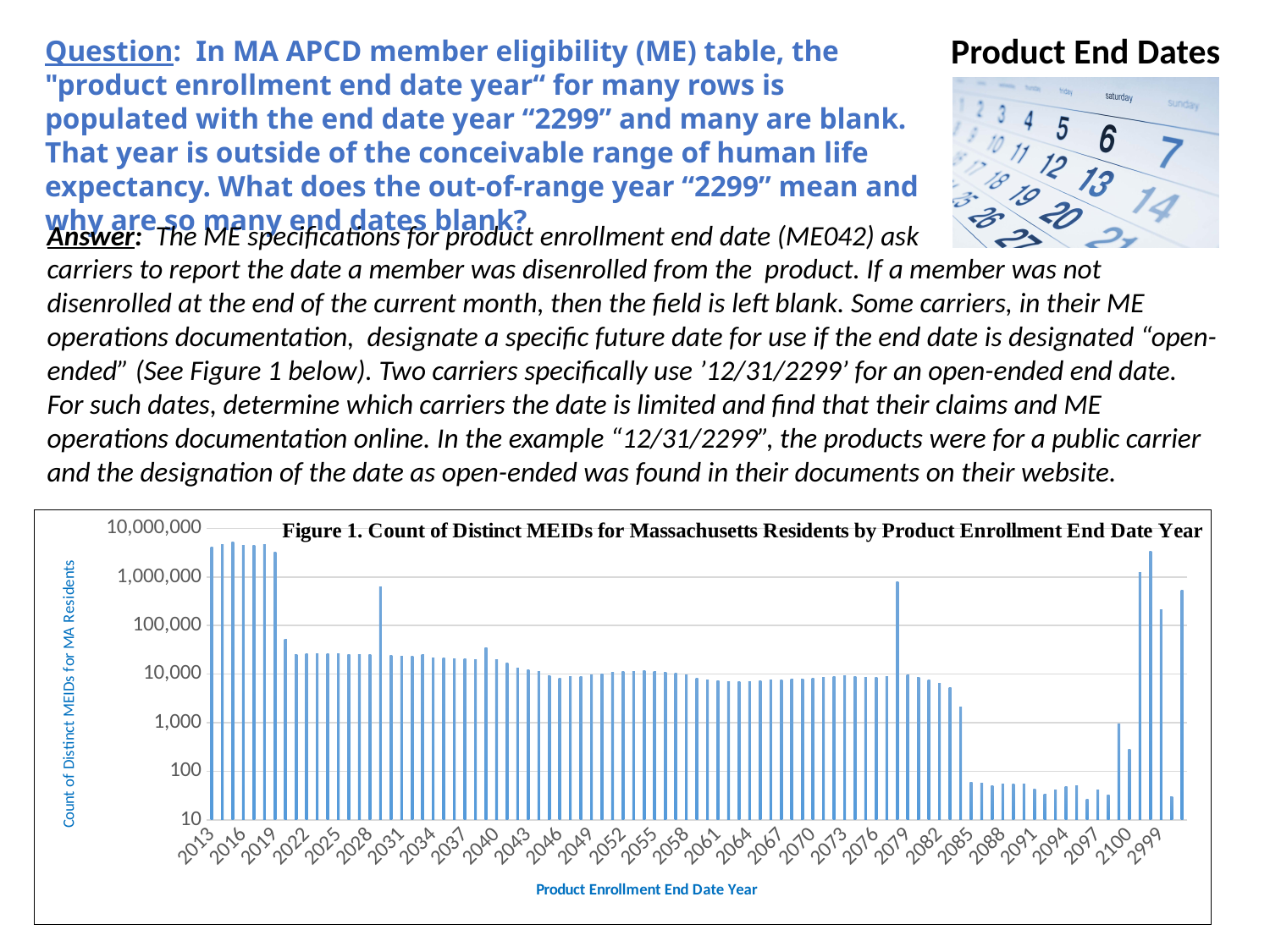
What is the x-axis title of the chart? Product Enrollment End Date Year Is the value for 2085 greater or less than 1,000? less Between 2043 and 2082, do the values generally rise or fall along the x axis? fall Is the value for 2079 greater or less than 100,000? less Is the value for 2022 greater or less than 100,000? less What kind of chart is Figure 1? bar chart Which has the larger value, 2013 or 2022? 2013 What is the title of the chart on the slide? Figure 1. Count of Distinct MEIDs for Massachusetts Residents by Product Enrollment End Date Year